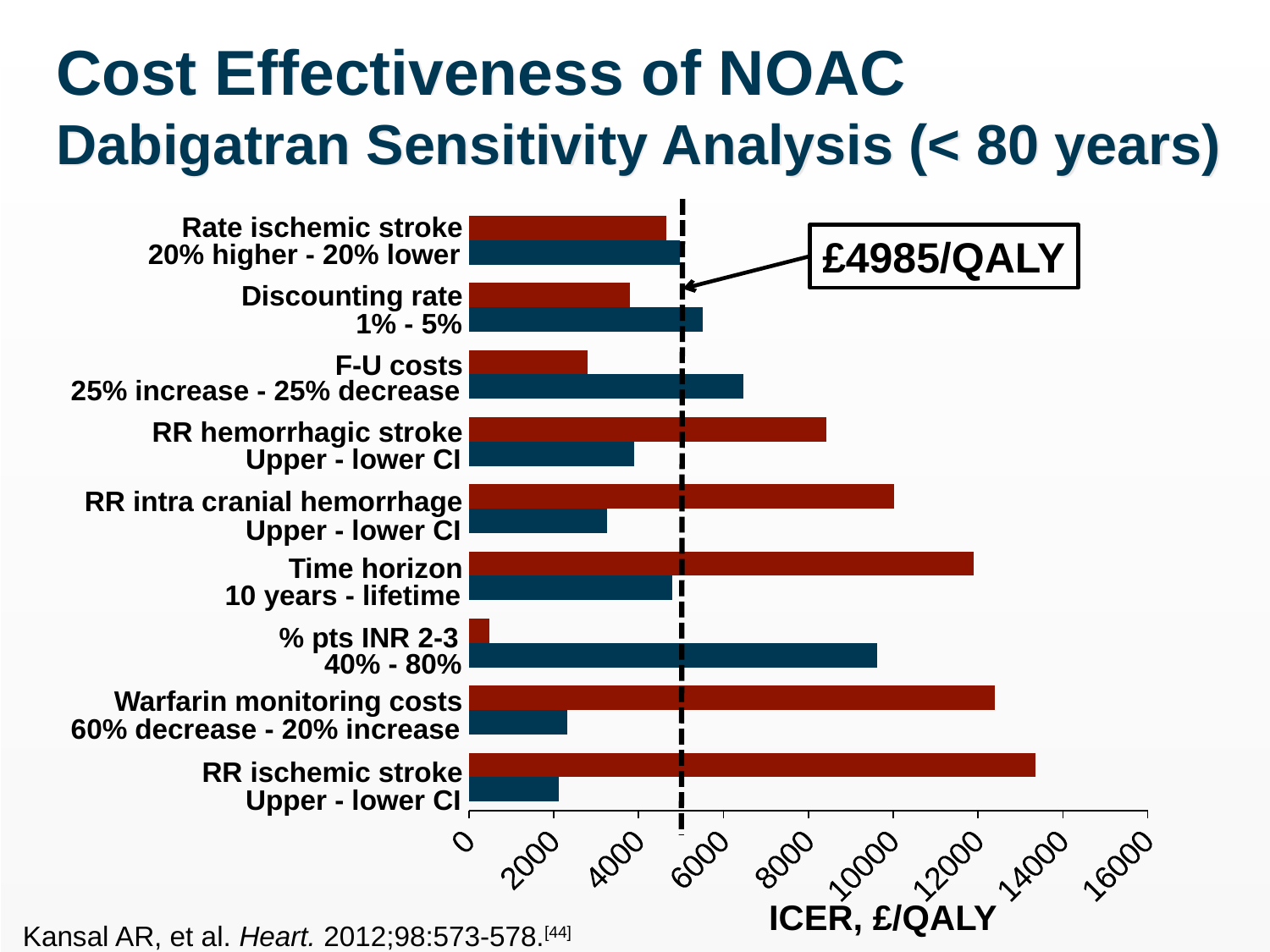
What value does the dashed vertical line on the chart represent, according to the annotation? £4985/QALY Which category has the shortest bar on the chart? % pts INR 2-3 40% - 80% Is the value of the blue bar for Warfarin monitoring costs 60% decrease - 20% increase greater or less than 4000? less Which category has the longest bar on the chart? RR ischemic stroke Upper - lower CI How many sensitivity parameters (categories) are listed on the y axis of the chart? 9 What kind of chart is shown on the slide? bar chart What is the x-axis title of the chart? ICER, £/QALY Which is larger: the red bar for RR intra cranial hemorrhage Upper - lower CI or the red bar for Discounting rate 1% - 5%? RR intra cranial hemorrhage Upper - lower CI Is the value of the red bar for RR ischemic stroke Upper - lower CI greater or less than 12000? greater Is the value of the red bar for Time horizon 10 years - lifetime greater or less than 10000? greater Which is larger: the blue bar for % pts INR 2-3 40% - 80% or the blue bar for RR ischemic stroke Upper - lower CI? % pts INR 2-3 40% - 80%